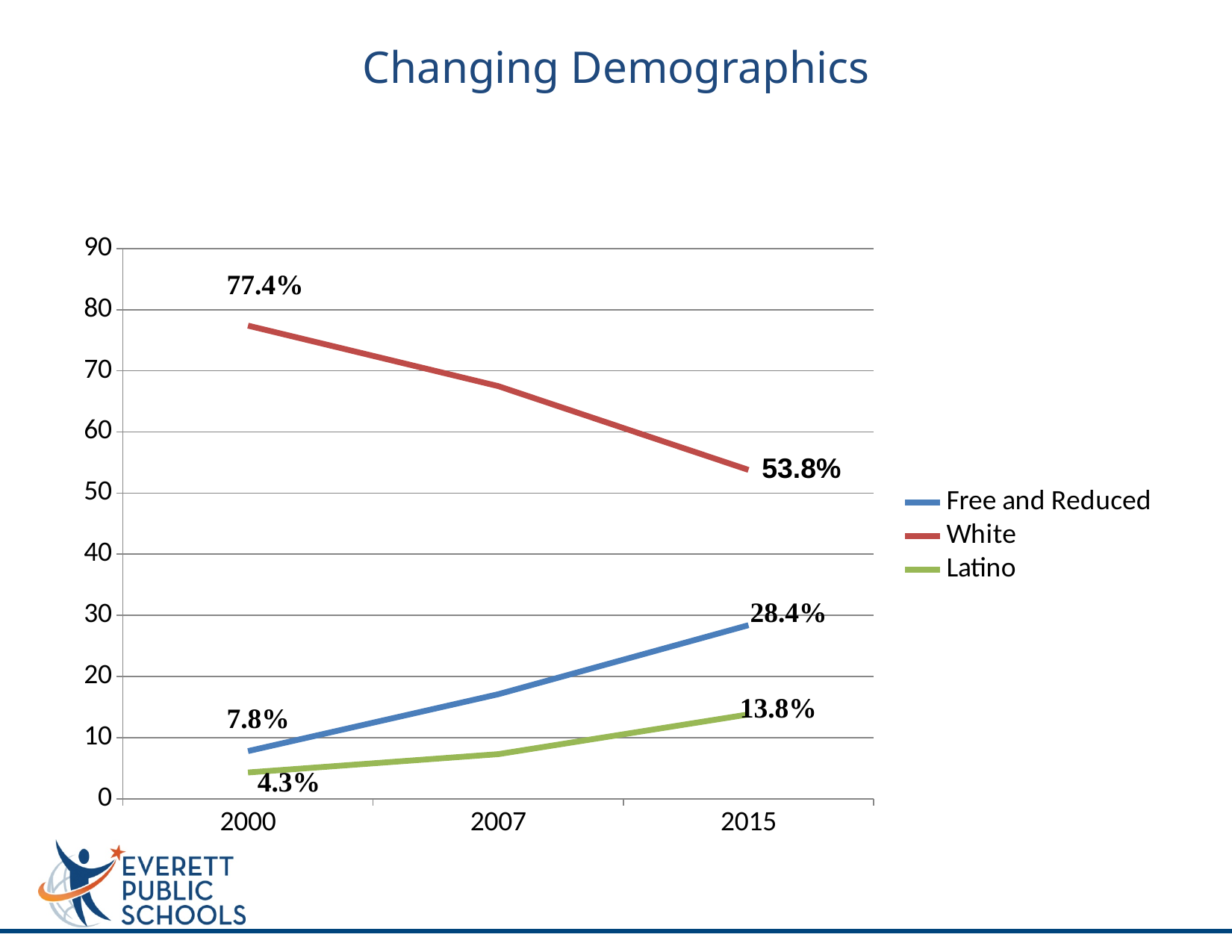
What is the value for Latino in 2000? 4.3% By how much did the White percentage fall from 2000 to 2015? 23.6% Which series has the highest value in 2015? White What is the value for Free and Reduced in 2015? 28.4% What type of chart is shown on the slide? line chart Which series has the lowest value in 2000? Latino What is the value for White in 2015? 53.8% How many series does the legend list? 3 Is the value for White in 2007 greater or less than 60? greater What is the difference between Free and Reduced and Latino in 2015? 14.6% What is the value for White in 2000? 77.4% Does the White line rise or fall from 2000 to 2015? fall